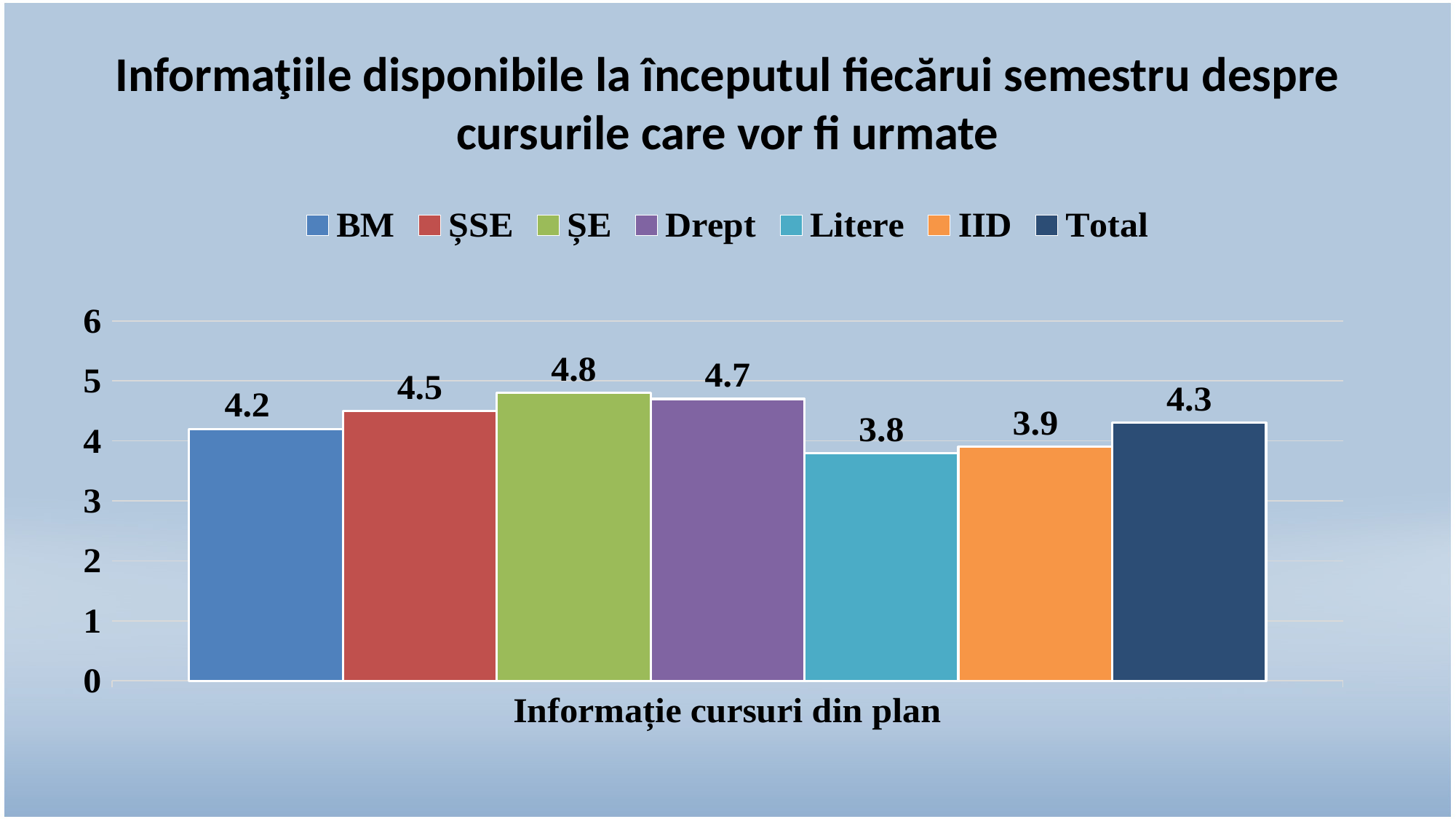
What is the value for Litere? 3.8 Is the value for IID greater or less than 4? less What is the difference between the values for ȘSE and BM? 0.3 What is the value for Total? 4.3 Which series has the highest value? ȘE Which is larger, the value for Drept or the value for IID? Drept What is the value for BM? 4.2 What is the difference between the values for ȘE and Litere? 1.0 What is the label on the x axis of the chart? Informație cursuri din plan Which series has the lowest value? Litere What kind of chart is shown on the slide? bar chart How many series does the legend list? 7